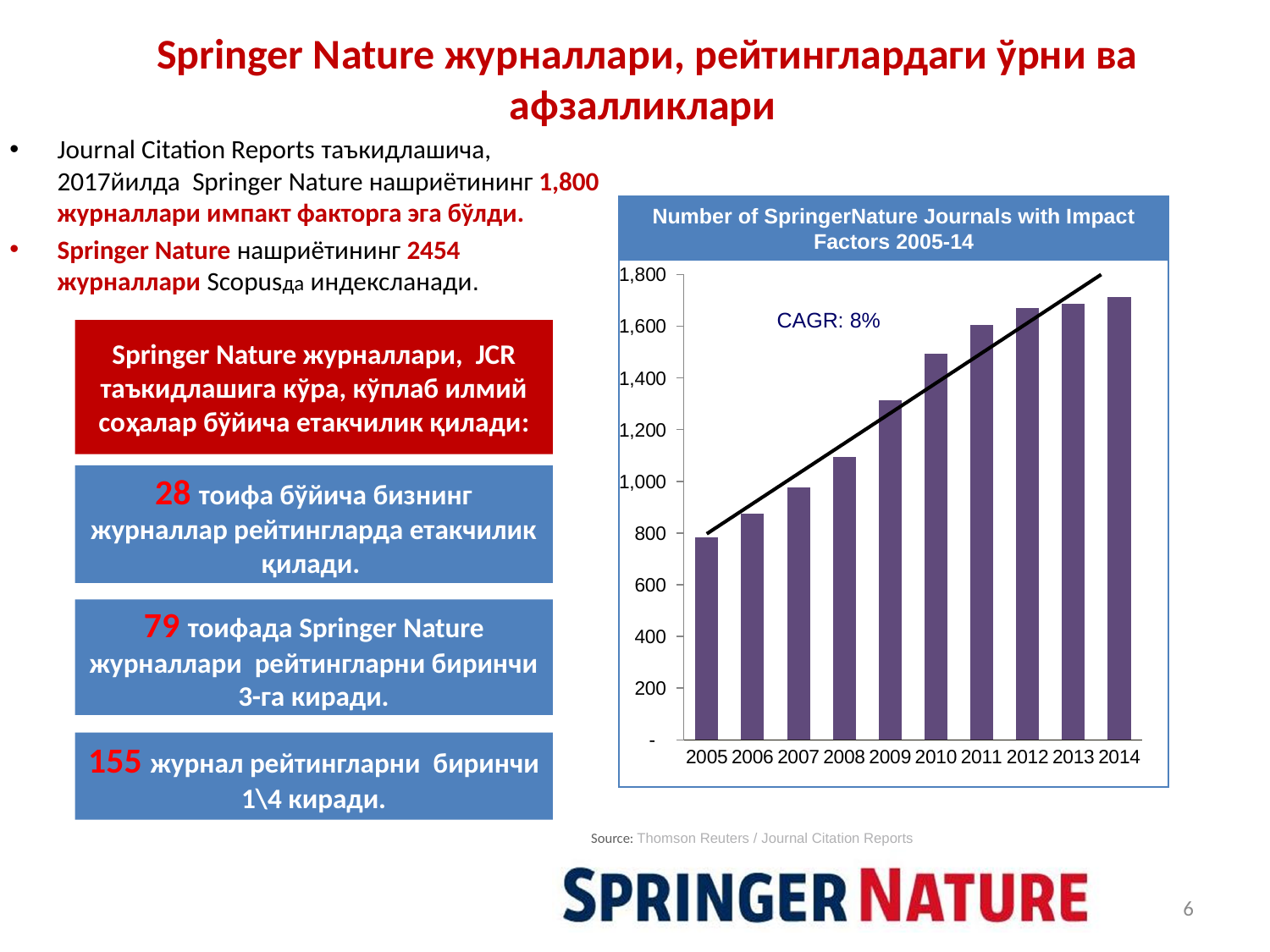
Is the value for 2009 greater or less than 1,200? greater Which year has the lowest number of journals with impact factors? 2005 Is the value for 2014 greater or less than 1,600? greater Is the value for 2010 greater or less than 1,400? greater What kind of chart is shown on the slide? bar chart Which is larger, the value for 2012 or the value for 2008? 2012 What is the title of the chart? Number of SpringerNature Journals with Impact Factors 2005-14 Do the values rise or fall from 2005 to 2014? rise How many years are shown on the x axis of the chart? 10 What CAGR is annotated on the chart? 8%